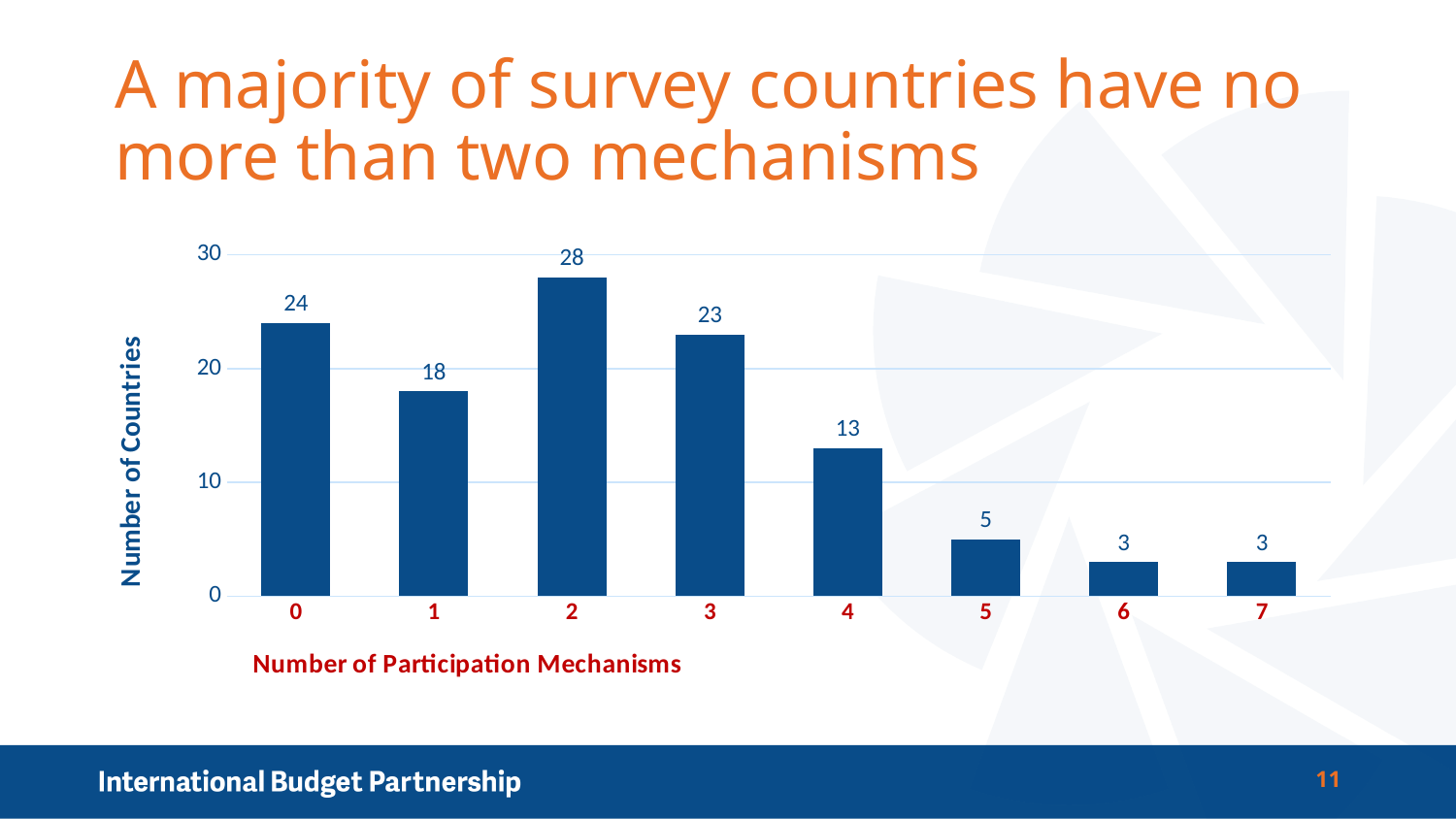
Which has more countries: 0 mechanisms or 3 mechanisms? 0 mechanisms What is the highest number of countries shown for any number of participation mechanisms? 28 What is the lowest number of countries shown on the chart? 3 What is the label of the y axis? Number of Countries How many countries have 4 participation mechanisms? 13 What is the difference in the number of countries between 2 mechanisms and 1 mechanism? 10 How many countries have 0 participation mechanisms? 24 Which number of participation mechanisms has the highest number of countries? 2 What kind of chart is shown on the slide? Bar chart How many countries have 5 participation mechanisms? 5 How many categories (numbers of participation mechanisms) are shown on the x axis? 8 What is the difference in the number of countries between 3 mechanisms and 4 mechanisms? 10